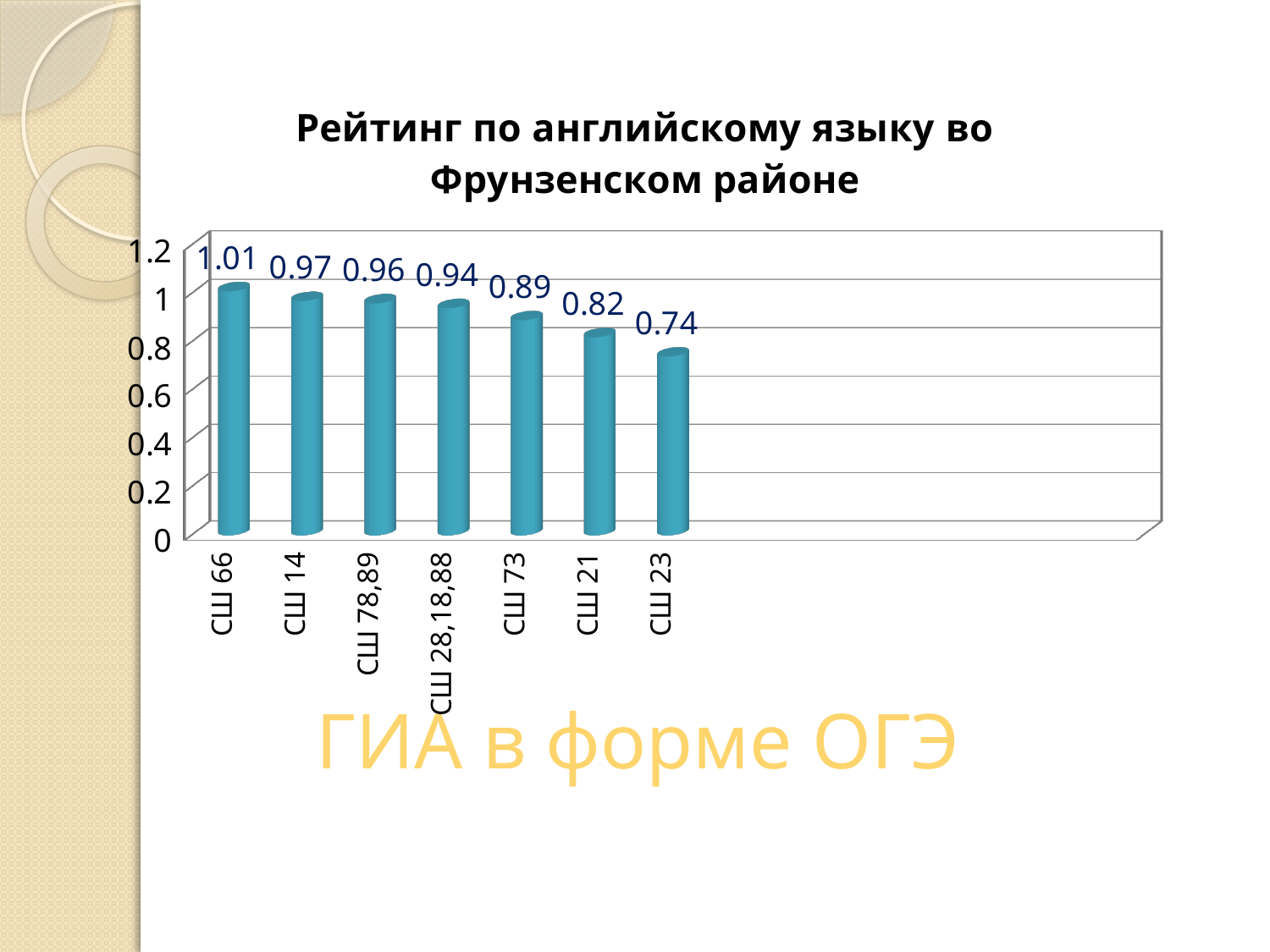
Which category has the highest value? СШ 66 What is the value for СШ 66? 1.01 What kind of chart is shown on the slide? bar chart What is the value for СШ 73? 0.89 What is the value for СШ 28,18,88? 0.94 Which is larger, the value for СШ 14 or the value for СШ 21? СШ 14 What is the difference between the values for СШ 66 and СШ 23? 0.27 Which category has the lowest value? СШ 23 What is the title of the chart? Рейтинг по английскому языку во Фрунзенском районе Is the value for СШ 21 greater or less than 1? less How many categories are shown in the chart? 7 Do the values rise or fall from left to right along the x axis? fall